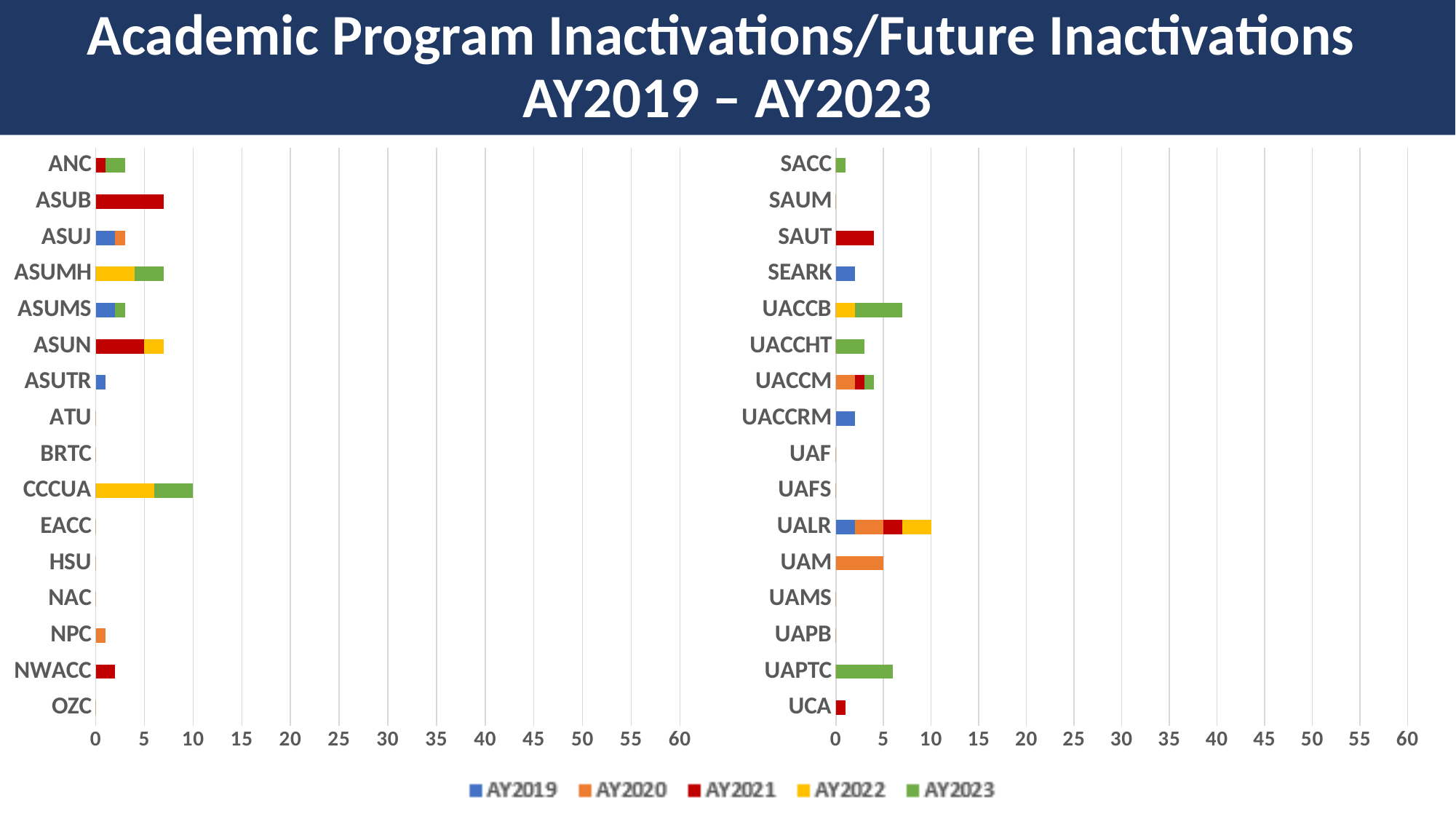
In the right chart, is the total value for SAUT greater or less than 5? less In the right chart, which has the larger total bar, UAPTC or UCA? UAPTC Which colour represents the AY2021 series in the legend? red In the right chart, how many institutions are listed on the vertical axis? 16 In the left chart, how many institutions are listed on the vertical axis? 16 In the left chart, which institution has the longest total bar? CCCUA In the left chart, is the total value for ASUB greater or less than 5? greater In the left chart, what is the total bar length for CCCUA? 10 In the right chart, which institution has the longest total bar? UALR In the right chart, what is the total bar length for UAM? 5 What kind of chart is shown on the left side of the slide? bar chart How many series does the legend list? 5